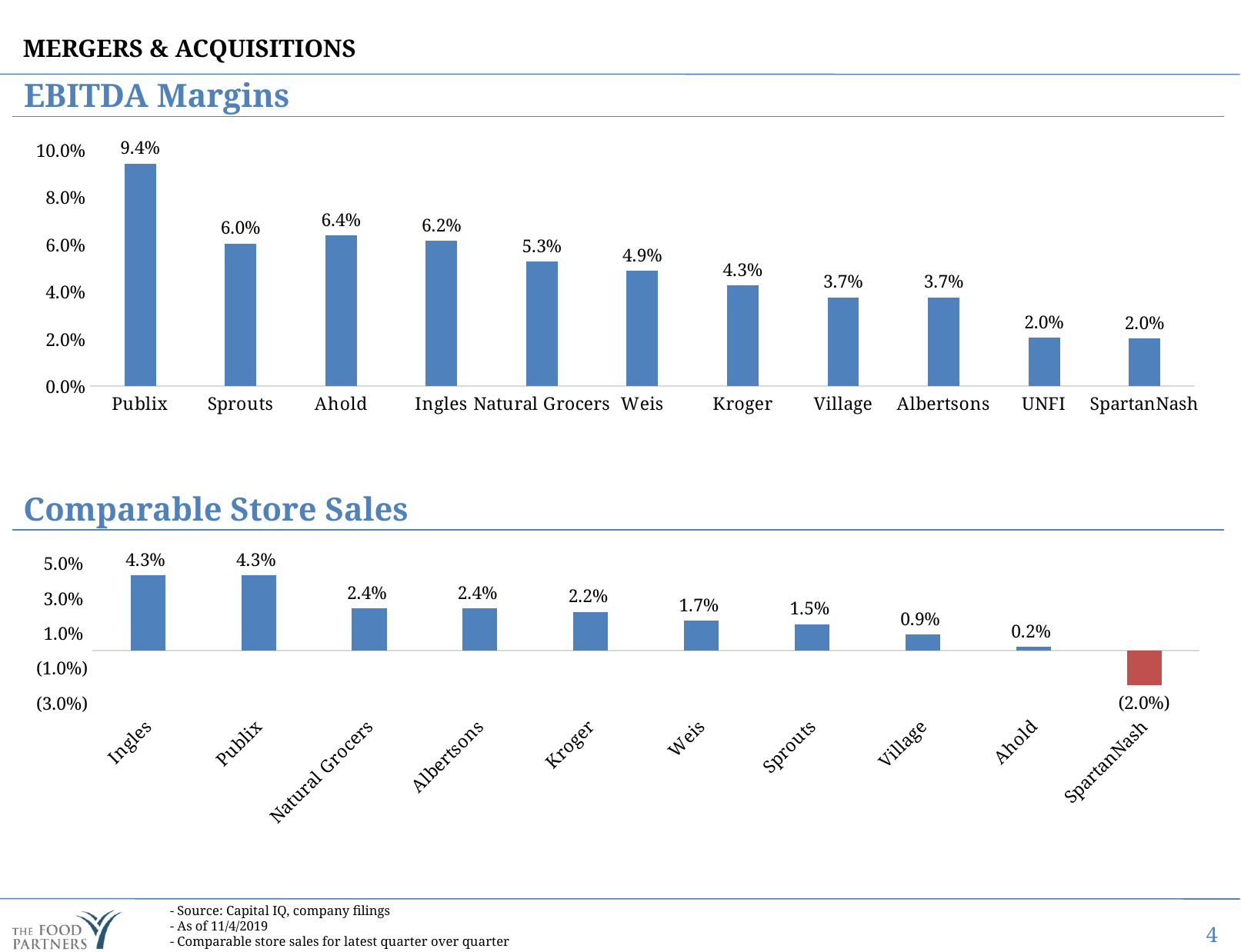
In the EBITDA Margins chart, which company has the highest EBITDA margin? Publix In the EBITDA Margins chart, what is the EBITDA margin for Natural Grocers? 5.3% In the Comparable Store Sales chart, which company has the lowest comparable store sales? SpartanNash What type of chart is the Comparable Store Sales chart? Bar chart In the EBITDA Margins chart, what is the difference between the EBITDA margins of Ahold and Kroger? 2.1% In the EBITDA Margins chart, which has a higher EBITDA margin, Sprouts or Weis? Sprouts In the Comparable Store Sales chart, what is the value for Kroger? 2.2% In the EBITDA Margins chart, how many companies are shown? 11 In the Comparable Store Sales chart, what is the value for SpartanNash? (2.0%) In the Comparable Store Sales chart, what colour is the bar for SpartanNash? Red In the EBITDA Margins chart, what is the EBITDA margin for Publix? 9.4% In the Comparable Store Sales chart, what is the difference between the values for Ingles and Weis? 2.6%